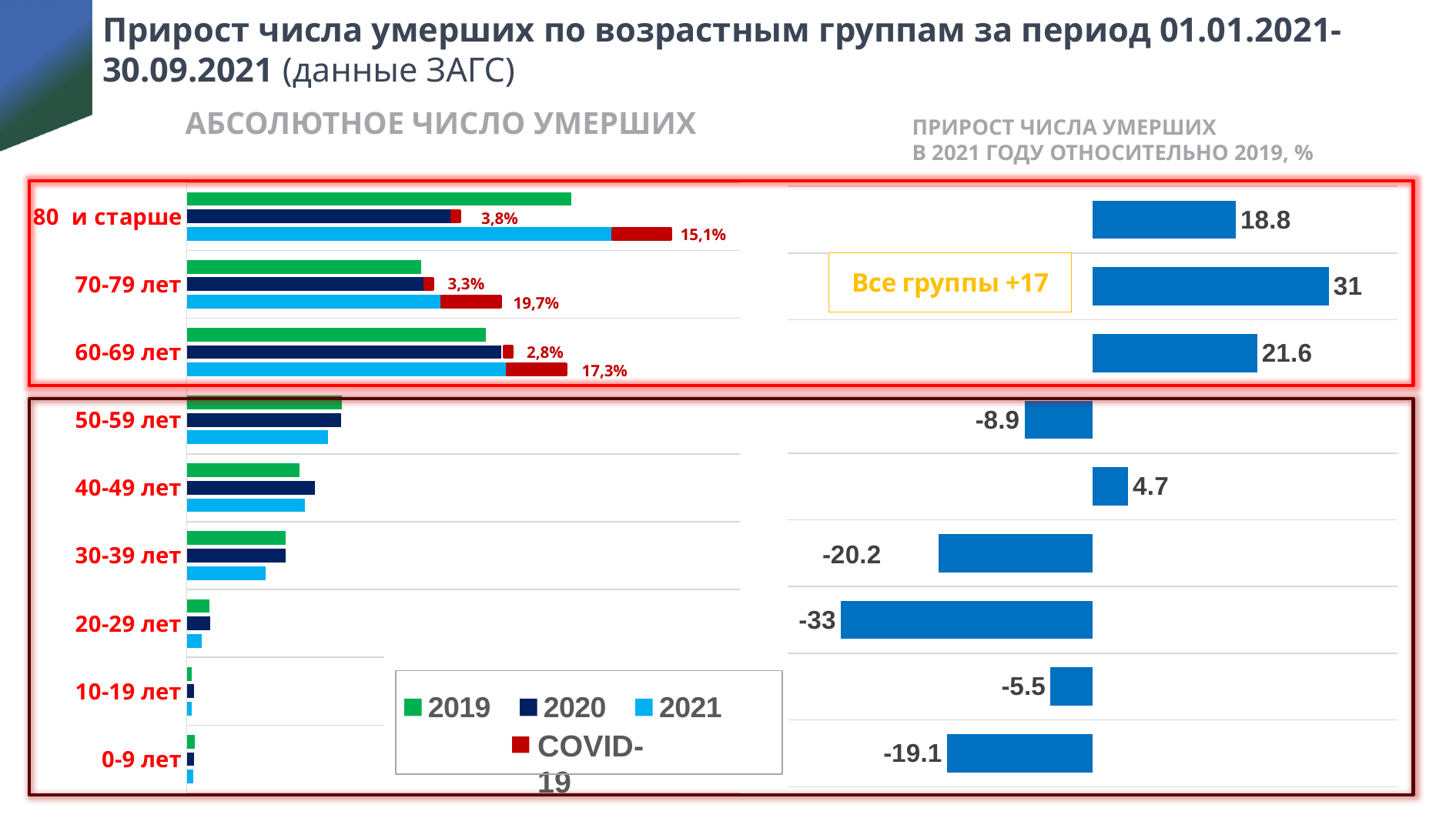
In the right chart (Прирост числа умерших в 2021 году относительно 2019, %), which age group has the highest value? 70-79 лет What kind of chart is the left chart (Абсолютное число умерших)? bar chart In the left chart (Абсолютное число умерших), what COVID-19 percentage is labelled on the 2020 bar for 80 и старше? 3,8% In the right chart (Прирост числа умерших в 2021 году относительно 2019, %), what is the value for 0-9 лет? -19.1 In the right chart (Прирост числа умерших в 2021 году относительно 2019, %), which age group has the lowest value? 20-29 лет In the right chart (Прирост числа умерших в 2021 году относительно 2019, %), what is the difference between the values for 70-79 лет and 60-69 лет? 9.4 In the left chart (Абсолютное число умерших), for 80 и старше, which bar is longer: 2019 or 2021? 2021 In the left chart (Абсолютное число умерших), what COVID-19 percentage is labelled on the 2021 bar for 70-79 лет? 19,7% In the right chart (Прирост числа умерших в 2021 году относительно 2019, %), what is the value for 70-79 лет? 31 In the right chart (Прирост числа умерших в 2021 году относительно 2019, %), which is larger: the value for 80 и старше or for 60-69 лет? 60-69 лет How many age groups are shown in the right chart (Прирост числа умерших в 2021 году относительно 2019, %)? 9 How many series does the legend of the left chart (Абсолютное число умерших) list? 4